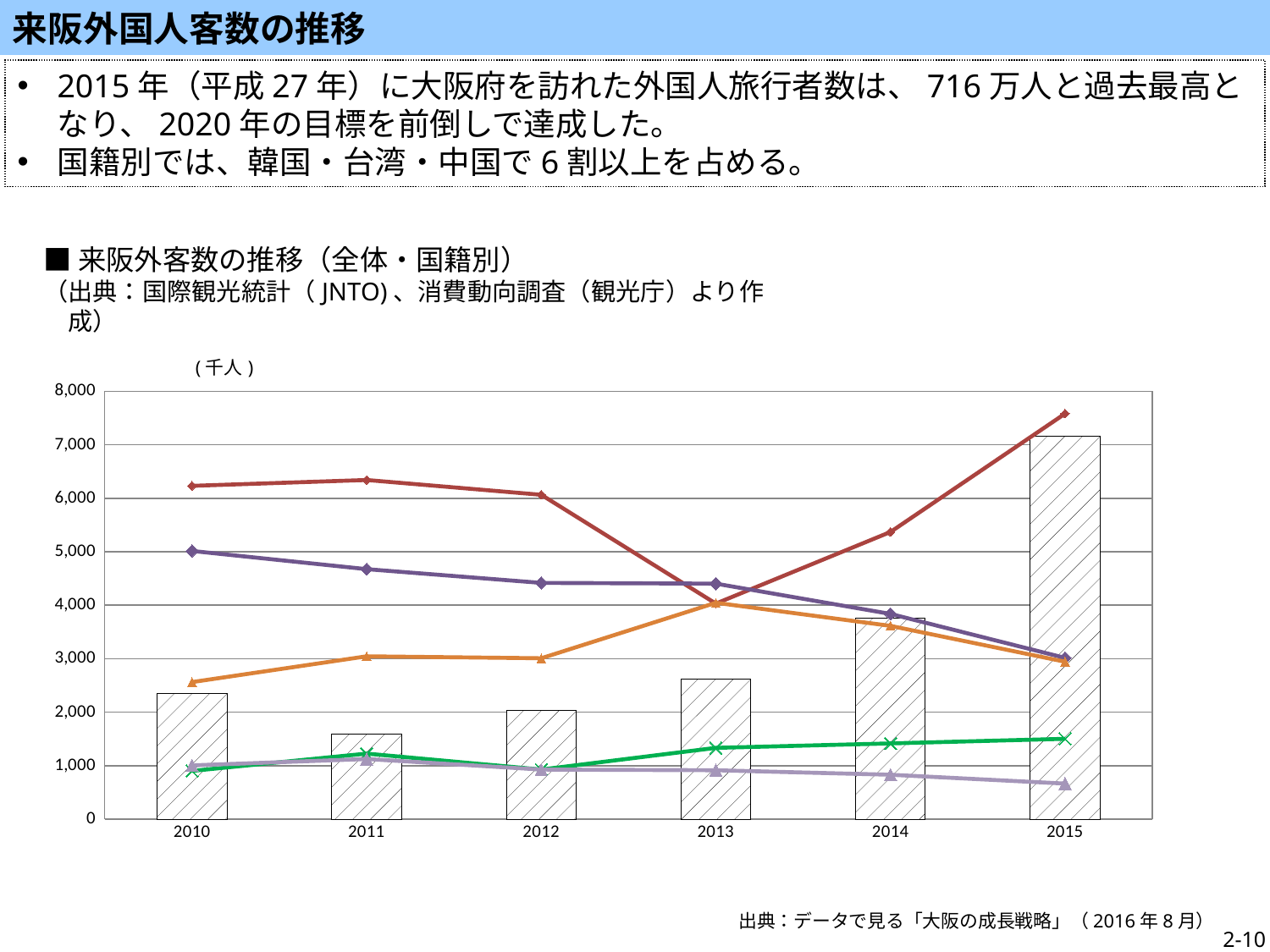
What is the title of the chart? 来阪外客数の推移（全体・国籍別） What unit is shown on the y axis of the chart? 千人 Which bar is taller, 2013 or 2012? 2013 Is the bar for 2015 greater or less than 6,000? greater Is the bar for 2011 greater or less than 2,000? less Which year has the shortest bar in the chart? 2011 What kind of chart is shown on the slide? A combination of a bar chart and line chart Is the bar for 2014 greater or less than 3,000? greater Which year has the tallest bar in the chart? 2015 How many years are shown on the x axis of the chart? 6 Do the bars rise or fall from 2012 to 2015? rise